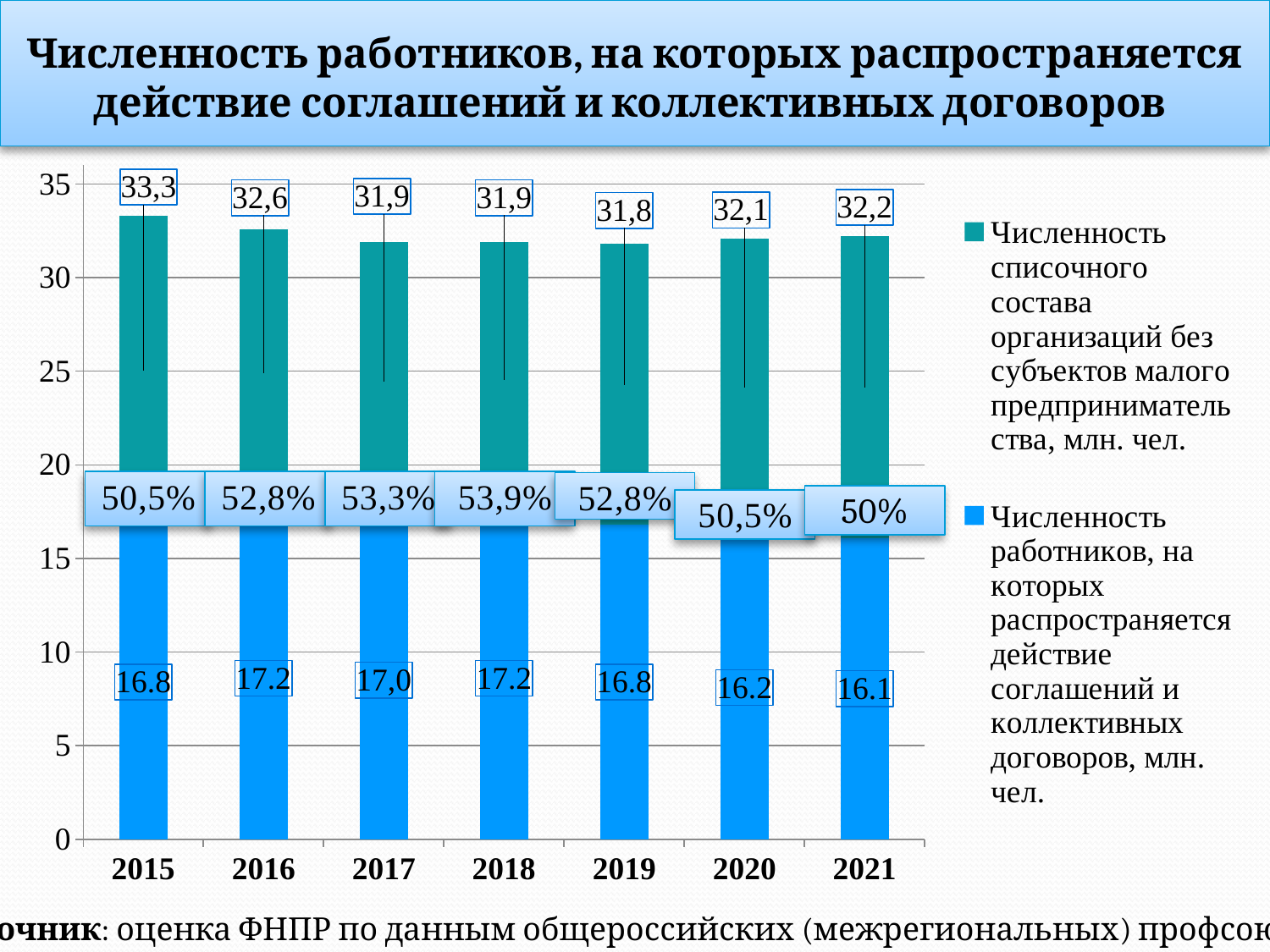
In which year is the blue series (работники под действием соглашений) lowest? 2021 In which year is the teal series (списочный состав) highest? 2015 How many series does the legend list? 2 Which is larger: the blue series value for 2016 or for 2020? 2016 Is the teal bar for 2019 greater or less than 30? greater Does the blue series (работники под действием соглашений) rise or fall from 2018 to 2021? fall How many years are shown on the x axis? 7 What is the value of the blue series (численность работников, на которых распространяется действие соглашений) for 2017? 17,0 What kind of chart is shown on the slide? bar chart What is the difference between the teal value for 2015 and the teal value for 2021? 1,1 What is the value of the teal series (численность списочного состава организаций) for 2015? 33,3 What percentage label is shown for 2018? 53,9%